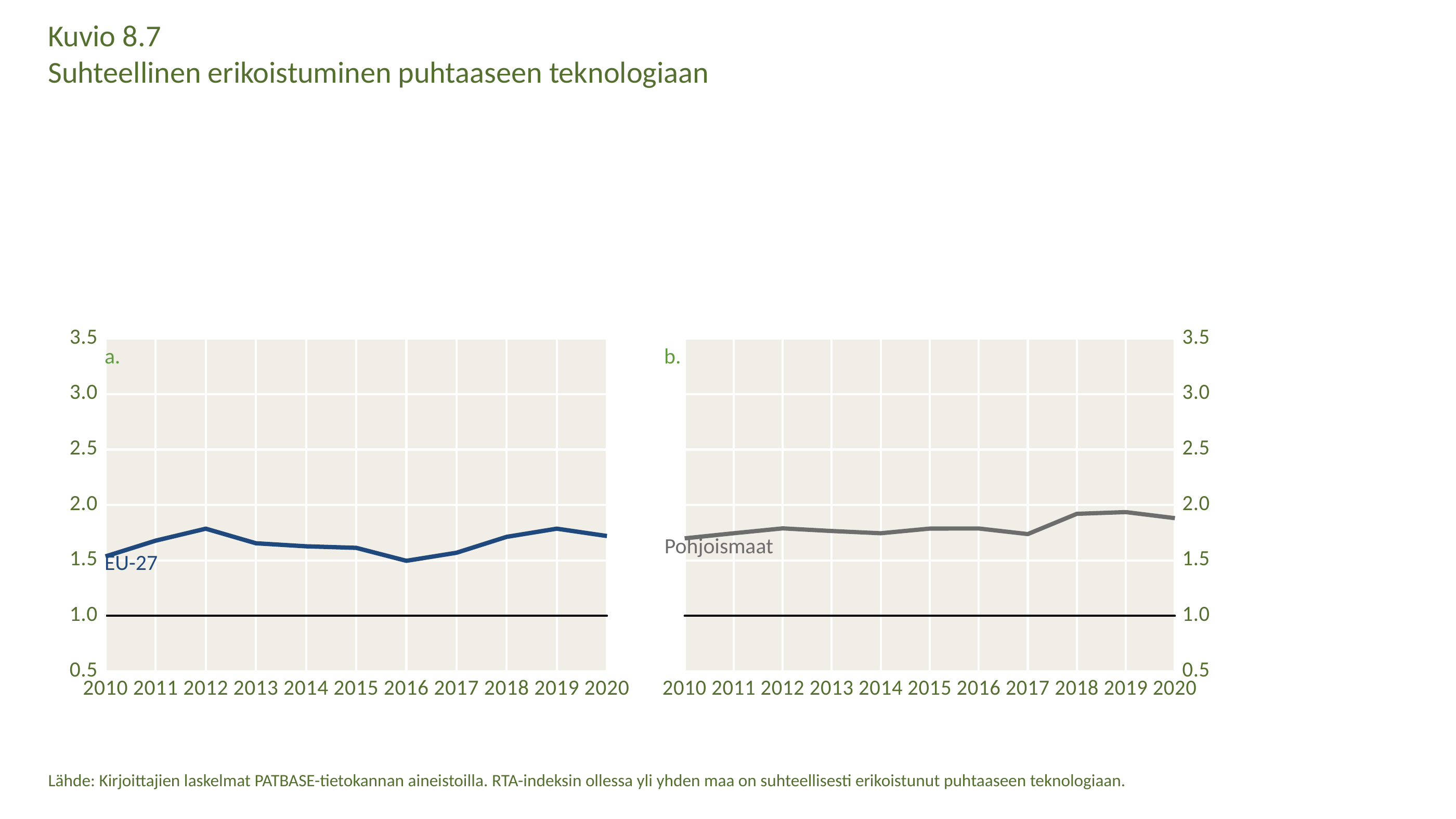
In chart a. (EU-27), is the value for 2012 greater or less than 1.5? greater In chart b. (Pohjoismaat), which year has the larger value, 2010 or 2018? 2018 In chart b. (Pohjoismaat), is the value for 2010 greater or less than 1.5? greater Which series is shown in chart b., the right-hand chart? Pohjoismaat In chart a. (EU-27), is the value for 2019 greater or less than 2.0? less In chart a. (EU-27), which year has the larger value, 2012 or 2016? 2012 How many years are plotted on the x axis of chart b. (Pohjoismaat)? 11 What kind of chart is chart a. (EU-27)? line chart In chart a. (EU-27), which year has the lowest value? 2016 In chart a. (EU-27), does the line rise or fall from 2012 to 2016? fall In chart b. (Pohjoismaat), which year has the lowest value? 2010